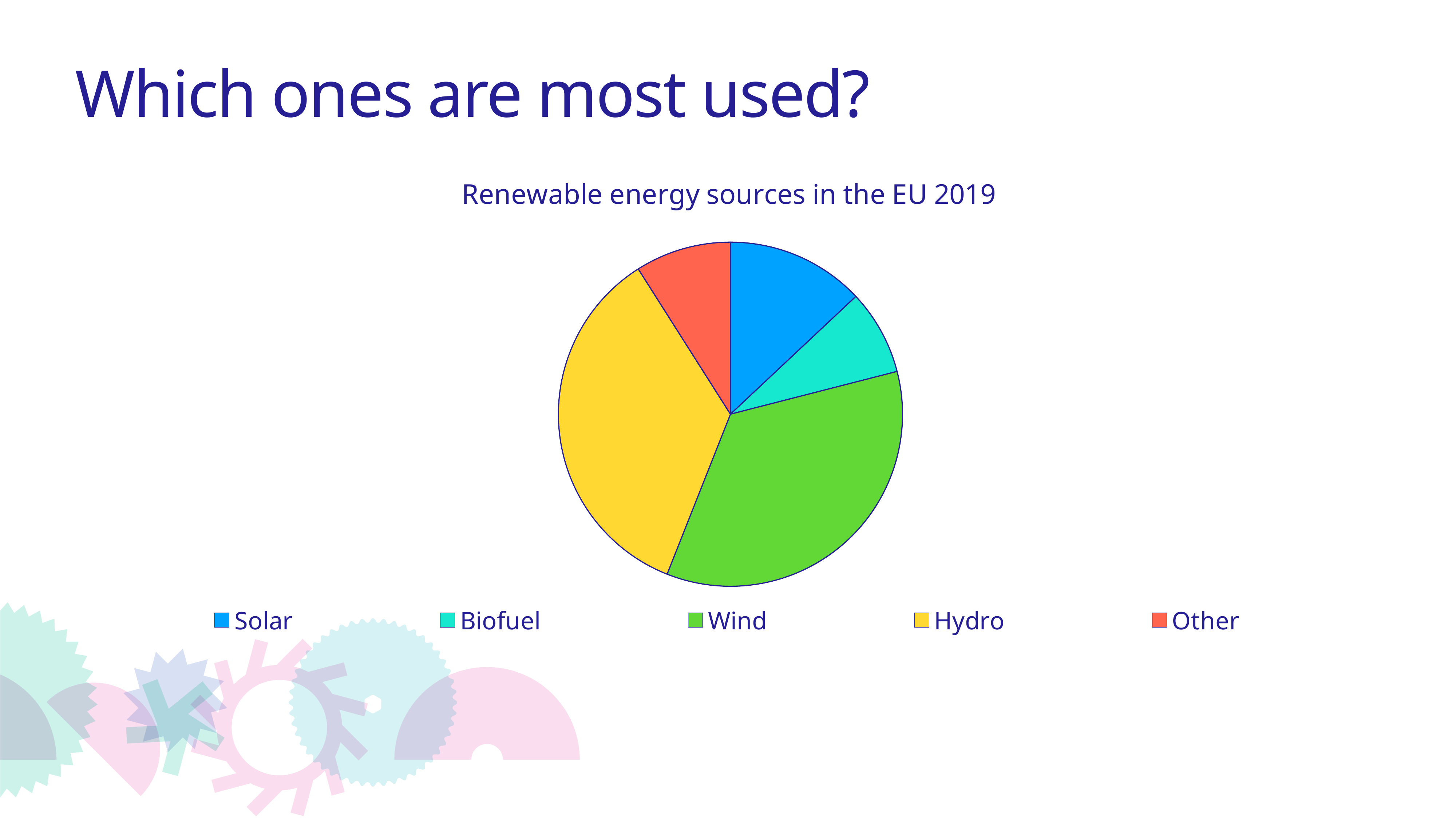
Which colour represents Hydro in the pie chart? yellow Which slice is larger, Solar or Biofuel? Solar Which slice is larger, Hydro or Biofuel? Hydro Which slice is larger, Wind or Solar? Wind What is the title of the pie chart? Renewable energy sources in the EU 2019 How many slices does the pie chart have? 5 How many entries does the legend of the pie chart list? 5 What kind of chart is shown on the slide? pie chart